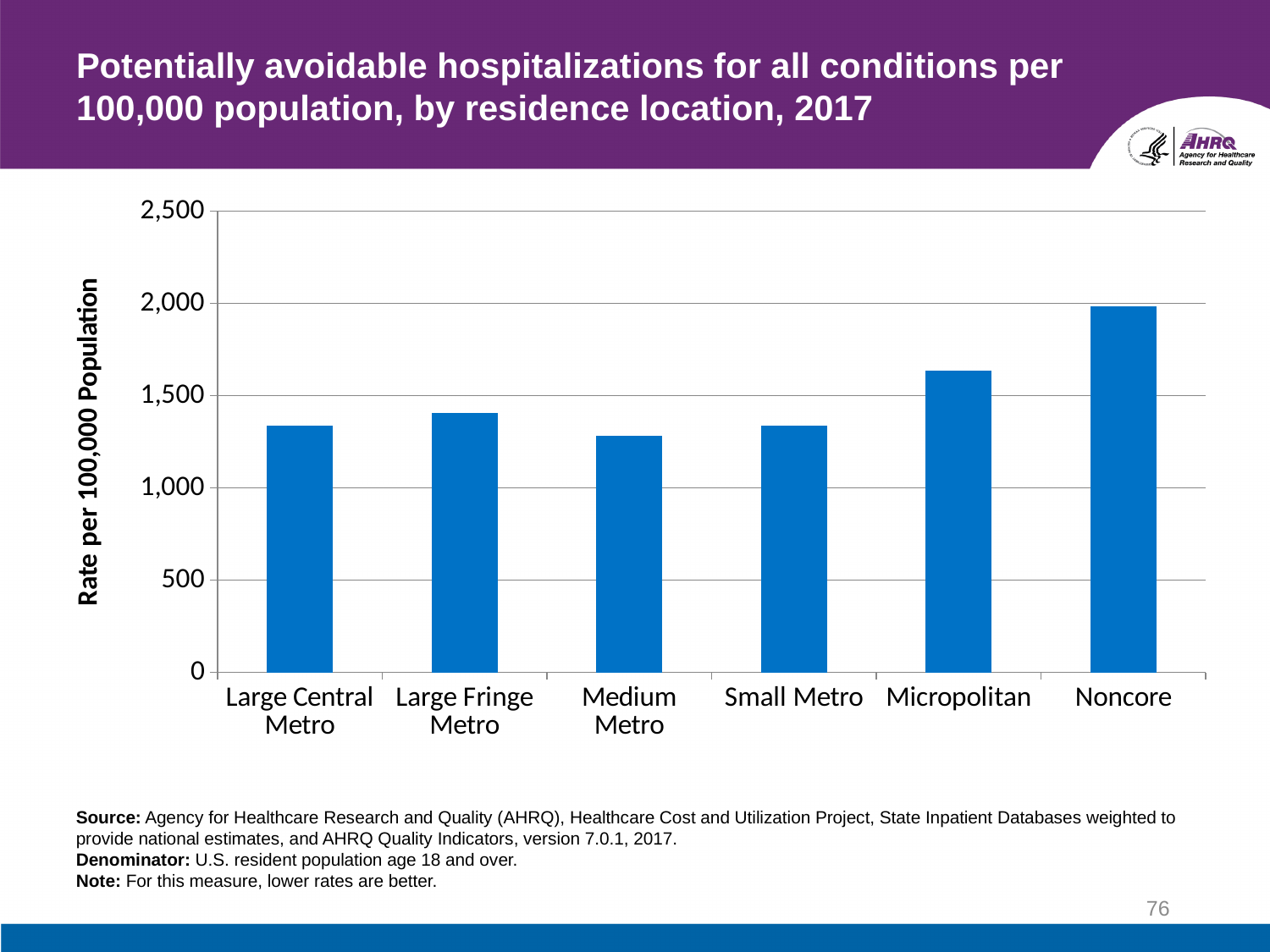
Is the value for Micropolitan greater or less than 2,000? less Is the value for Noncore greater or less than 1,500? greater How many residence location categories are shown on the x axis? 6 Which has a higher rate, Micropolitan or Large Central Metro? Micropolitan What is the label on the y axis of the chart? Rate per 100,000 Population Which residence location has the lowest rate of potentially avoidable hospitalizations? Medium Metro Is the value for Large Central Metro greater or less than 1,000? greater Which residence location has the highest rate of potentially avoidable hospitalizations? Noncore Which has a higher rate, Large Fringe Metro or Medium Metro? Large Fringe Metro What kind of chart is shown on the slide? bar chart What year does the chart's title say the data are for? 2017